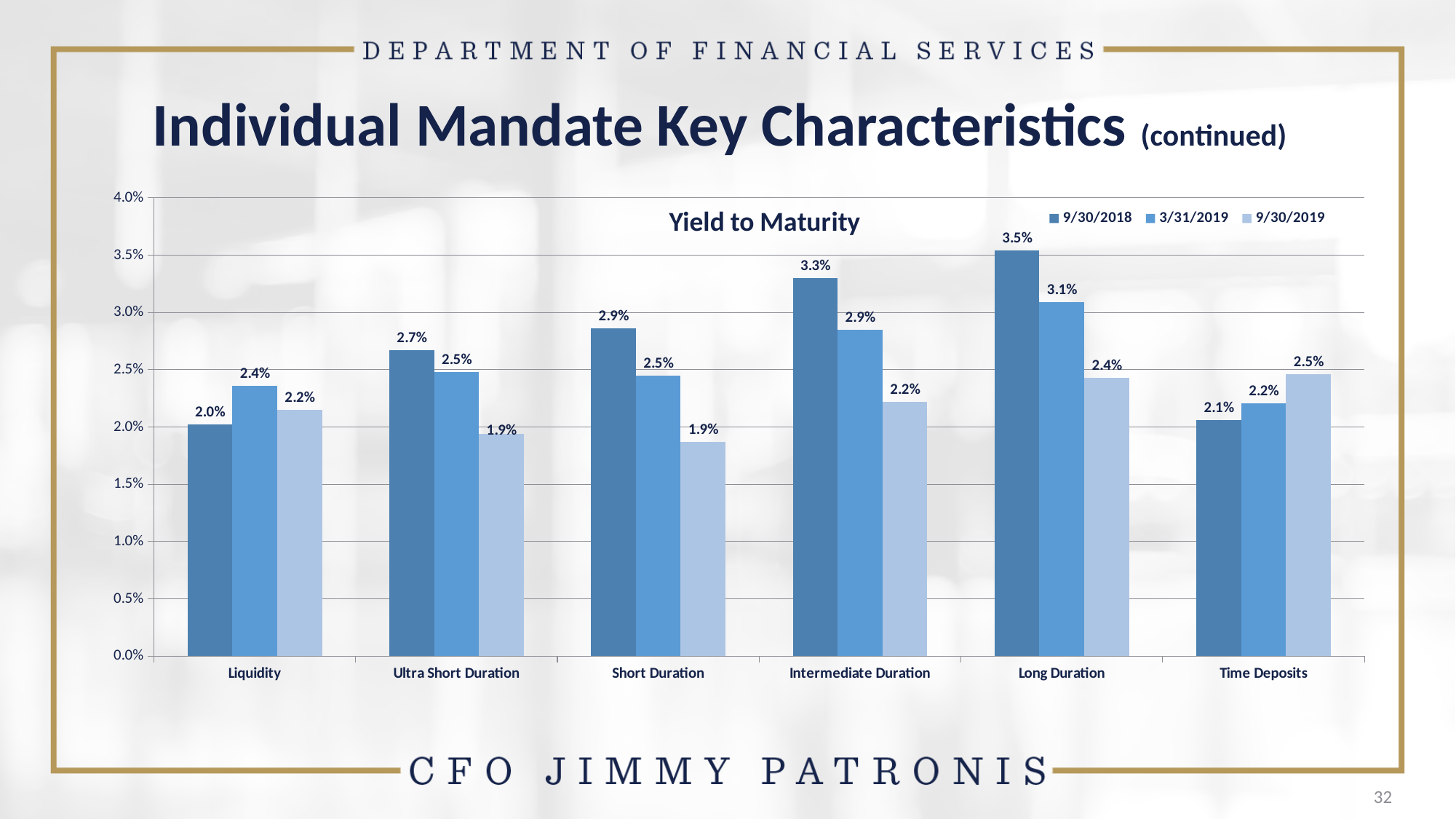
Which category has the highest Yield to Maturity for the 9/30/2018 series? Long Duration For Time Deposits, do the values rise or fall from 9/30/2018 to 9/30/2019? Rise What is the Yield to Maturity for Long Duration as of 9/30/2018? 3.5% How many categories are shown on the x axis of the Yield to Maturity chart? 6 How many series does the legend of the Yield to Maturity chart list? 3 What is the Yield to Maturity for Intermediate Duration as of 3/31/2019? 2.9% Which is larger: the 9/30/2019 Yield to Maturity for Time Deposits or for Liquidity? Time Deposits Is the 9/30/2018 Yield to Maturity for Intermediate Duration greater or less than 3.0%? greater What kind of chart is the Yield to Maturity chart? Bar chart What is the difference between the 9/30/2018 and 9/30/2019 Yield to Maturity for Long Duration? 1.1% Which category has the lowest Yield to Maturity for the 9/30/2018 series? Liquidity What is the Yield to Maturity for Time Deposits as of 9/30/2019? 2.5%